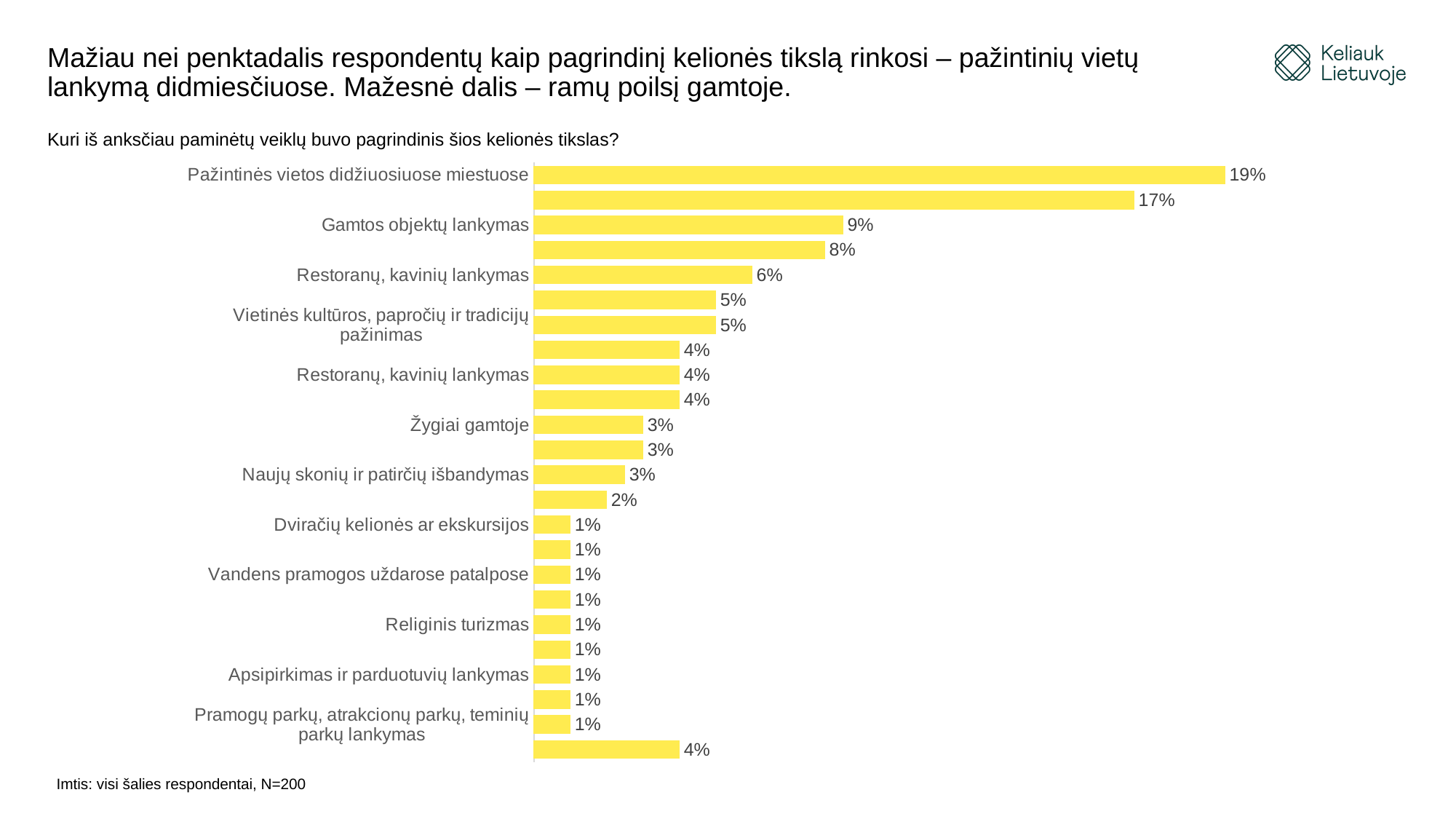
How many bars are plotted in the chart? 24 What is the difference between the values for Pažintinės vietos didžiuosiuose miestuose and Gamtos objektų lankymas? 10 percentage points Which is larger, the value for Gamtos objektų lankymas or the value for Žygiai gamtoje? Gamtos objektų lankymas What is the value for Žygiai gamtoje? 3% What kind of chart is shown on the slide? bar chart What is the value for Naujų skonių ir patirčių išbandymas? 3% What is the value for Gamtos objektų lankymas? 9% What colour are the bars in the chart? yellow What is the value for Pažintinės vietos didžiuosiuose miestuose? 19% Which category has the highest value? Pažintinės vietos didžiuosiuose miestuose What is the value for Dviračių kelionės ar ekskursijos? 1% What is the value for Religinis turizmas? 1%